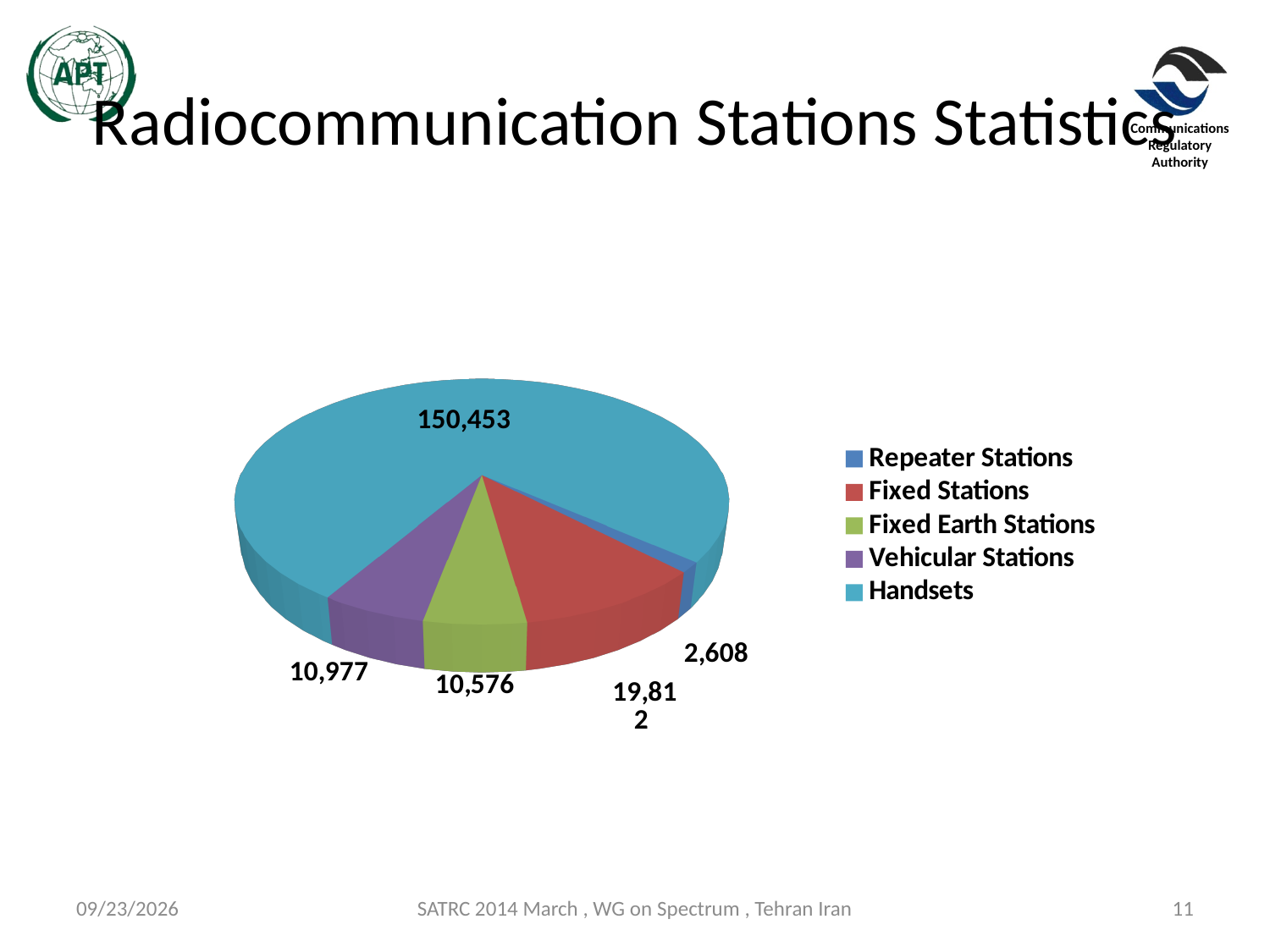
What is the difference between the values for Fixed Stations and Repeater Stations? 17,204 What kind of chart is shown on the slide? Pie chart Which category has the largest slice of the pie? Handsets What is the difference between the values for Vehicular Stations and Fixed Earth Stations? 401 Which is larger, the value for Vehicular Stations or the value for Fixed Earth Stations? Vehicular Stations What is the value shown for Fixed Earth Stations? 10,576 What is the value shown for Fixed Stations? 19,812 What is the value shown for Handsets? 150,453 Which category has the smallest slice of the pie? Repeater Stations What is the value shown for Vehicular Stations? 10,977 What is the value shown for Repeater Stations? 2,608 How many categories does the legend list? 5